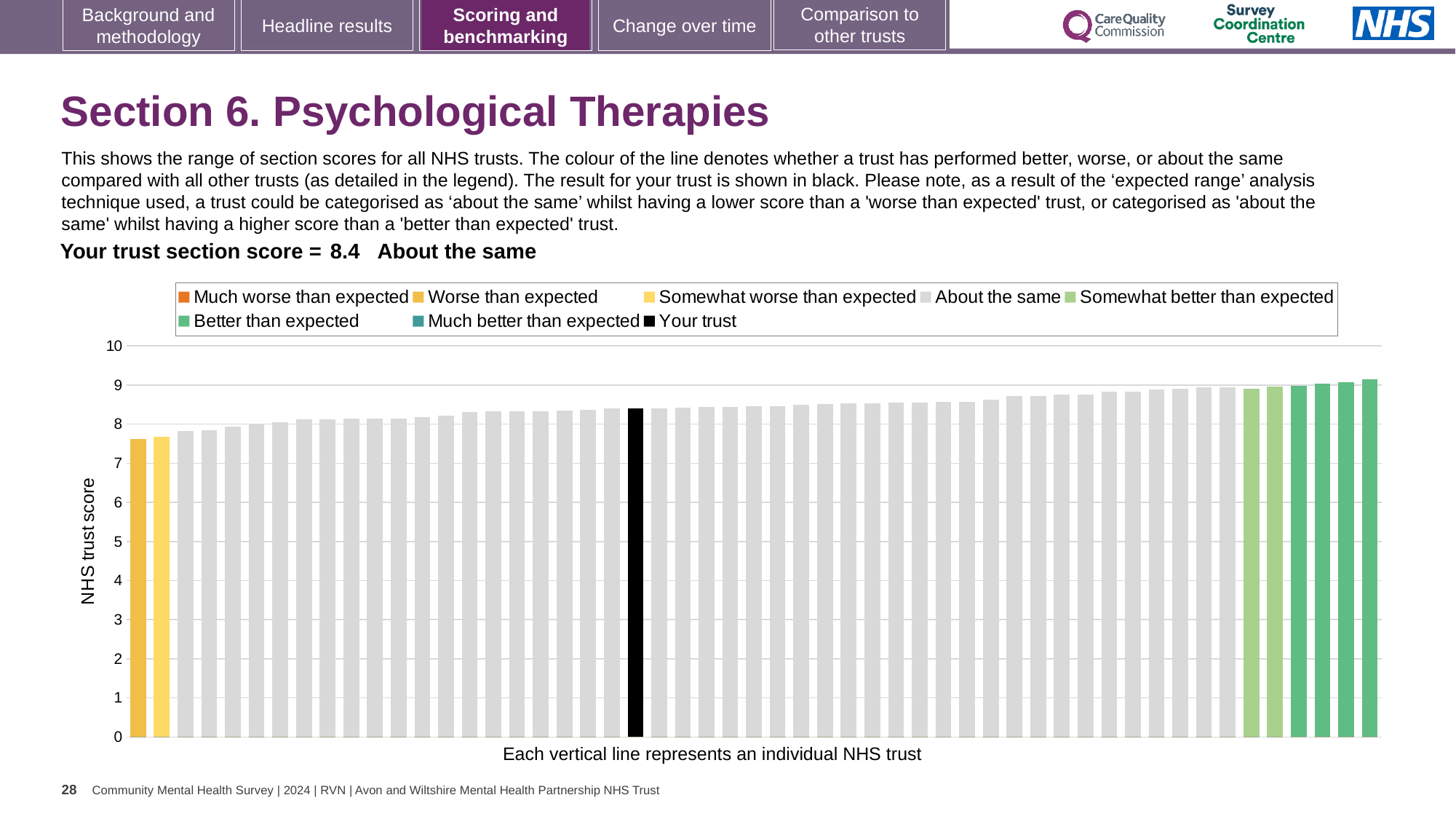
Do the bar values rise or fall from left to right along the x axis? rise Is the value of the lowest bar in the chart greater or less than 8? less How many entries does the chart legend list? 8 How many bars are coloured as 'Better than expected' (green)? 4 Is the value of the black 'Your trust' bar greater or less than 8? greater Which is larger: the value of the 'Your trust' bar or the value of the leftmost bar? Your trust What is the label on the y axis of the chart? NHS trust score How many bars are coloured as 'Worse than expected' (yellow)? 1 Which performance category is your trust's section score assigned to? About the same What kind of chart is shown on the slide? bar chart Is the value of the highest bar in the chart greater or less than 9? greater What is the section score for your trust shown on the slide? 8.4